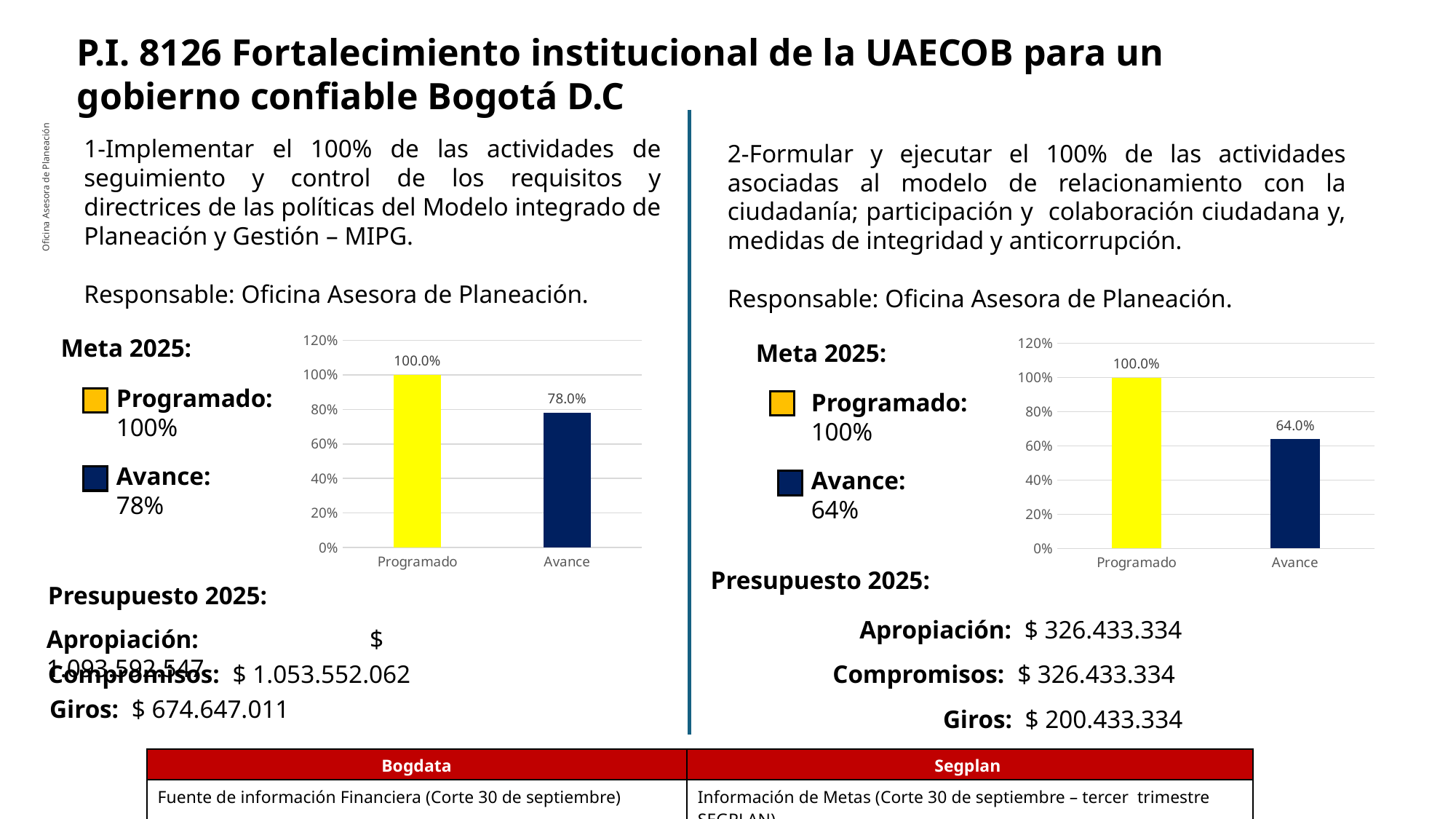
In the right chart, which category has the highest value? Programado How many categories are shown in the left chart? 2 In the right chart, what is the difference between Programado and Avance? 36.0% In the right chart, what is the value for Avance? 64.0% In the left chart, what is the value for Avance? 78.0% In the right chart, what is the value for Programado? 100.0% What kind of chart is the right chart? Bar chart In the right chart, is the value for Avance greater or less than 80%? less In the left chart, what is the value for Programado? 100.0% In the left chart, what colour is the Programado bar? Yellow In the left chart, what is the difference between Programado and Avance? 22.0% In the left chart, which category has the lowest value? Avance